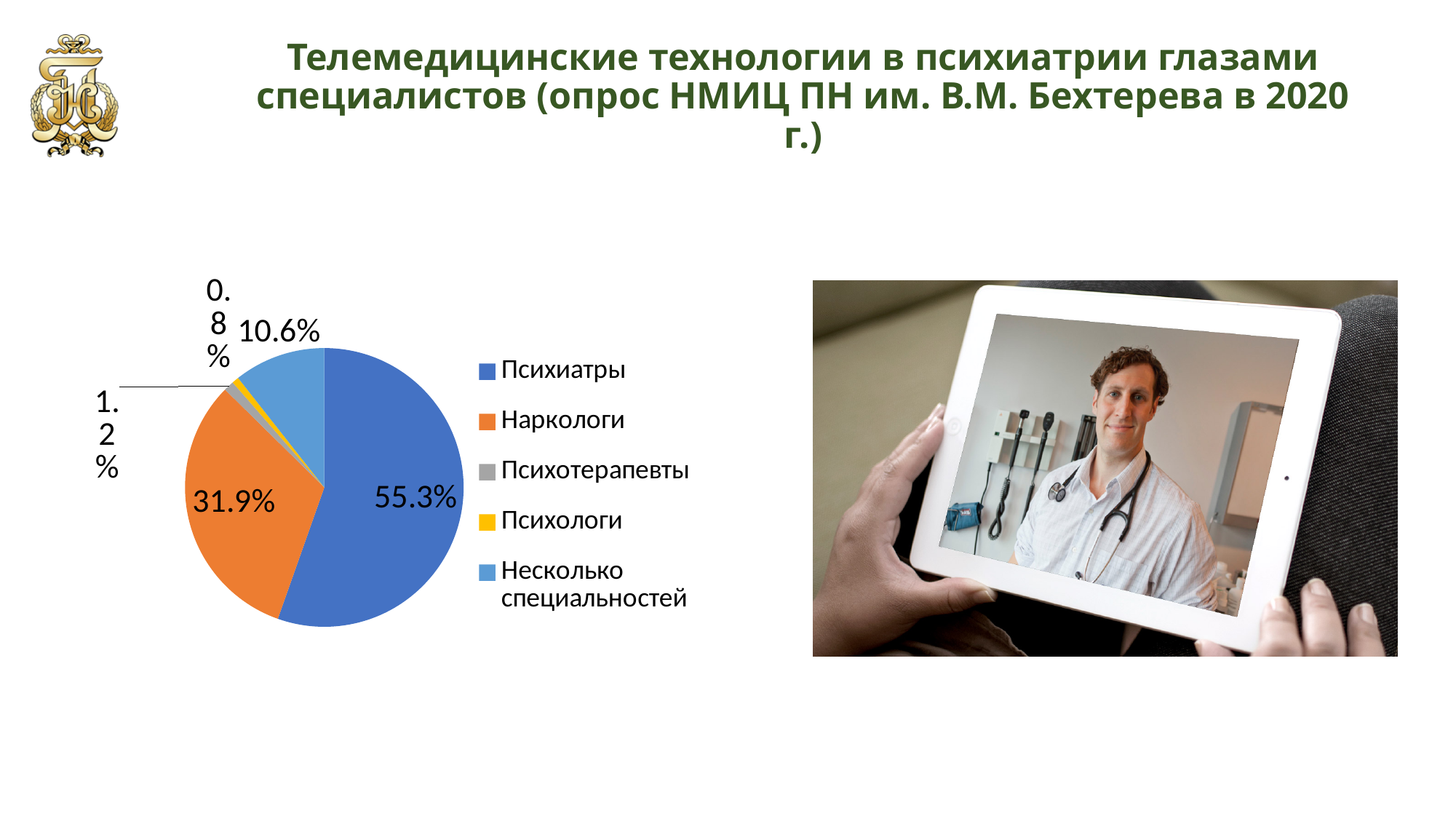
What share of the pie chart is labelled for Психотерапевты? 1.2% What share of the pie chart is labelled for Несколько специальностей? 10.6% What is the difference in percentage points between the Психиатры and Наркологи slices? 23.4 What share of the pie chart is labelled for Психиатры? 55.3% What type of chart is shown on the slide? pie chart Which category has the smallest slice of the pie chart? Психологи What colour is the Наркологи slice in the pie chart? orange What share of the pie chart is labelled for Психологи? 0.8% What share of the pie chart is labelled for Наркологи? 31.9% Which slice is larger: Наркологи or Несколько специальностей? Наркологи Which category has the largest slice of the pie chart? Психиатры How many categories does the pie chart legend list? 5